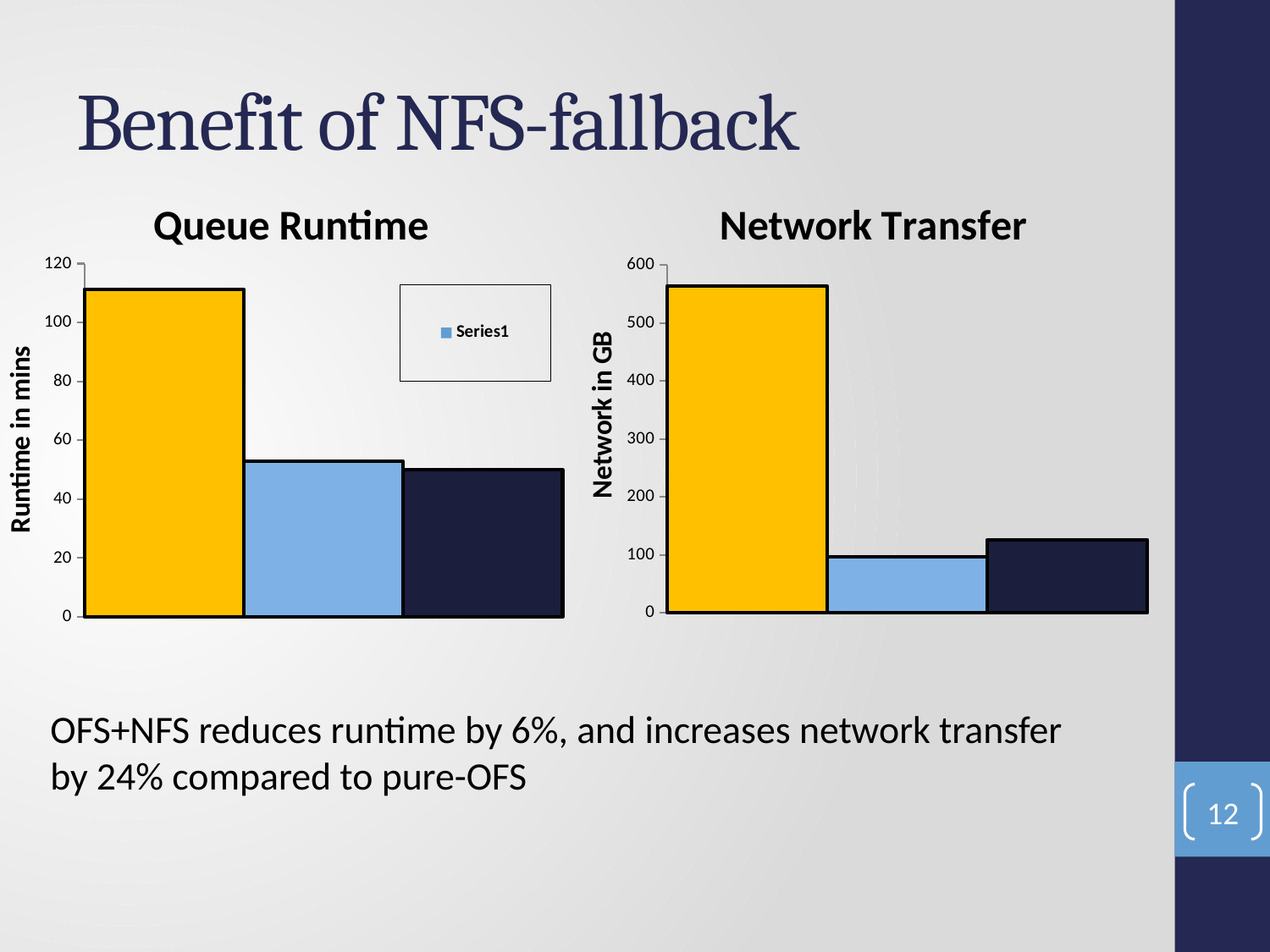
In the Queue Runtime chart, is the value of the first (yellow) bar greater or less than 100? greater In the Network Transfer chart, which is larger: the middle (light blue) bar or the third (dark navy) bar? the third (dark navy) bar In the Queue Runtime chart, which bar is the tallest? the first (yellow) bar In the Queue Runtime chart, which is larger: the first (yellow) bar or the middle (light blue) bar? the first (yellow) bar What is the y-axis title of the Network Transfer chart? Network in GB How many bars are plotted in the Network Transfer chart? 3 In the Network Transfer chart, is the value of the first (yellow) bar greater or less than 500? greater What kind of chart is the Queue Runtime chart? bar chart What entry does the legend of the Queue Runtime chart list? Series1 In the Queue Runtime chart, is the value of the third (dark navy) bar greater or less than 60? less In the Network Transfer chart, which bar is the lowest? the middle (light blue) bar